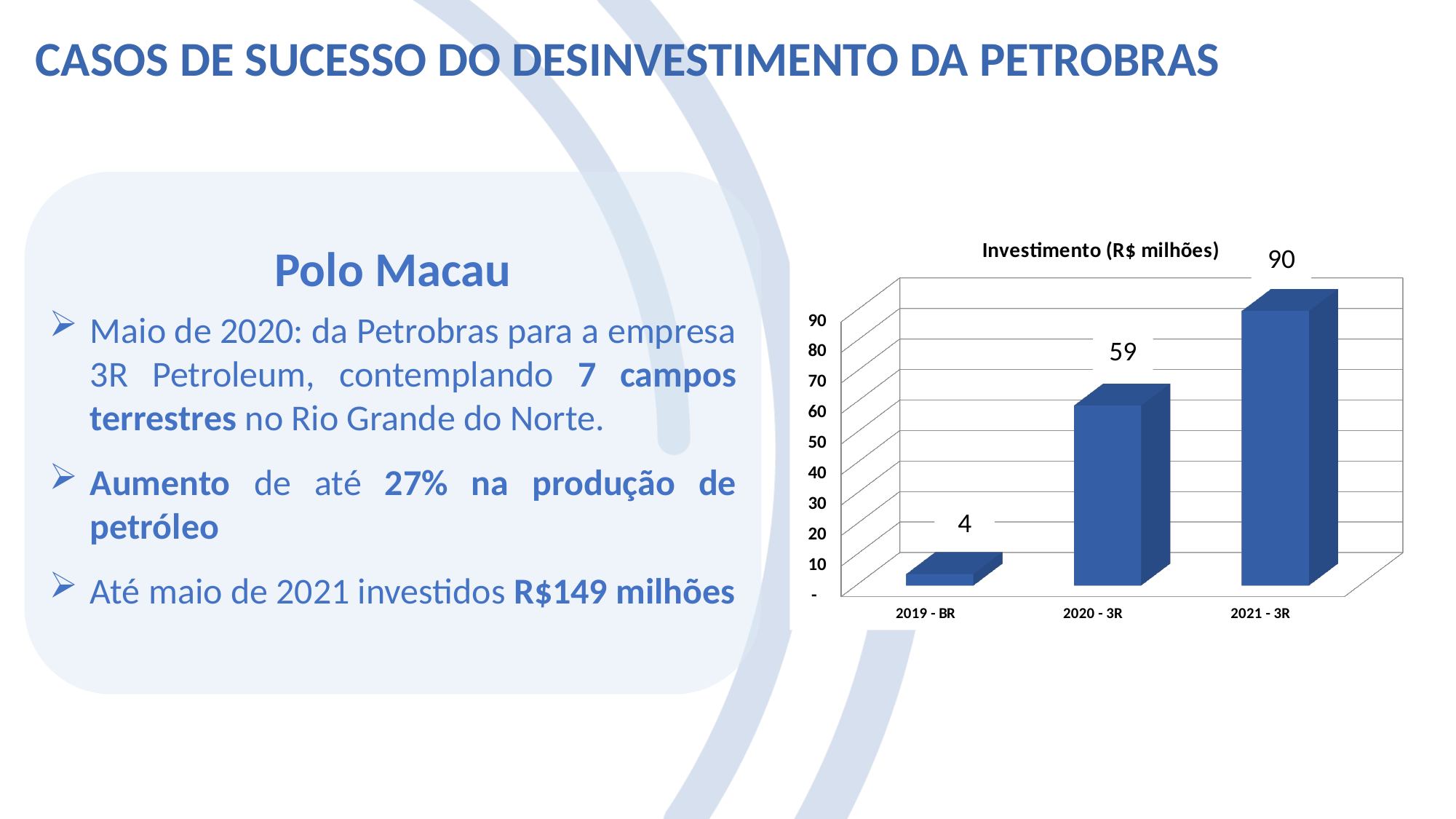
What is the value for 2019 - BR in the Investimento (R$ milhões) chart? 4 What is the value for 2021 - 3R in the Investimento (R$ milhões) chart? 90 What is the title of the chart? Investimento (R$ milhões) Which category has the lowest value in the Investimento (R$ milhões) chart? 2019 - BR What kind of chart is shown on the slide? Bar chart What is the difference between the values for 2020 - 3R and 2019 - BR? 55 How many categories are shown on the x axis of the chart? 3 What is the value for 2020 - 3R in the Investimento (R$ milhões) chart? 59 Which category has the highest value in the Investimento (R$ milhões) chart? 2021 - 3R Do the values rise or fall from 2019 - BR to 2021 - 3R? Rise What is the difference between the values for 2021 - 3R and 2020 - 3R? 31 Which is larger, the value for 2020 - 3R or the value for 2019 - BR? 2020 - 3R